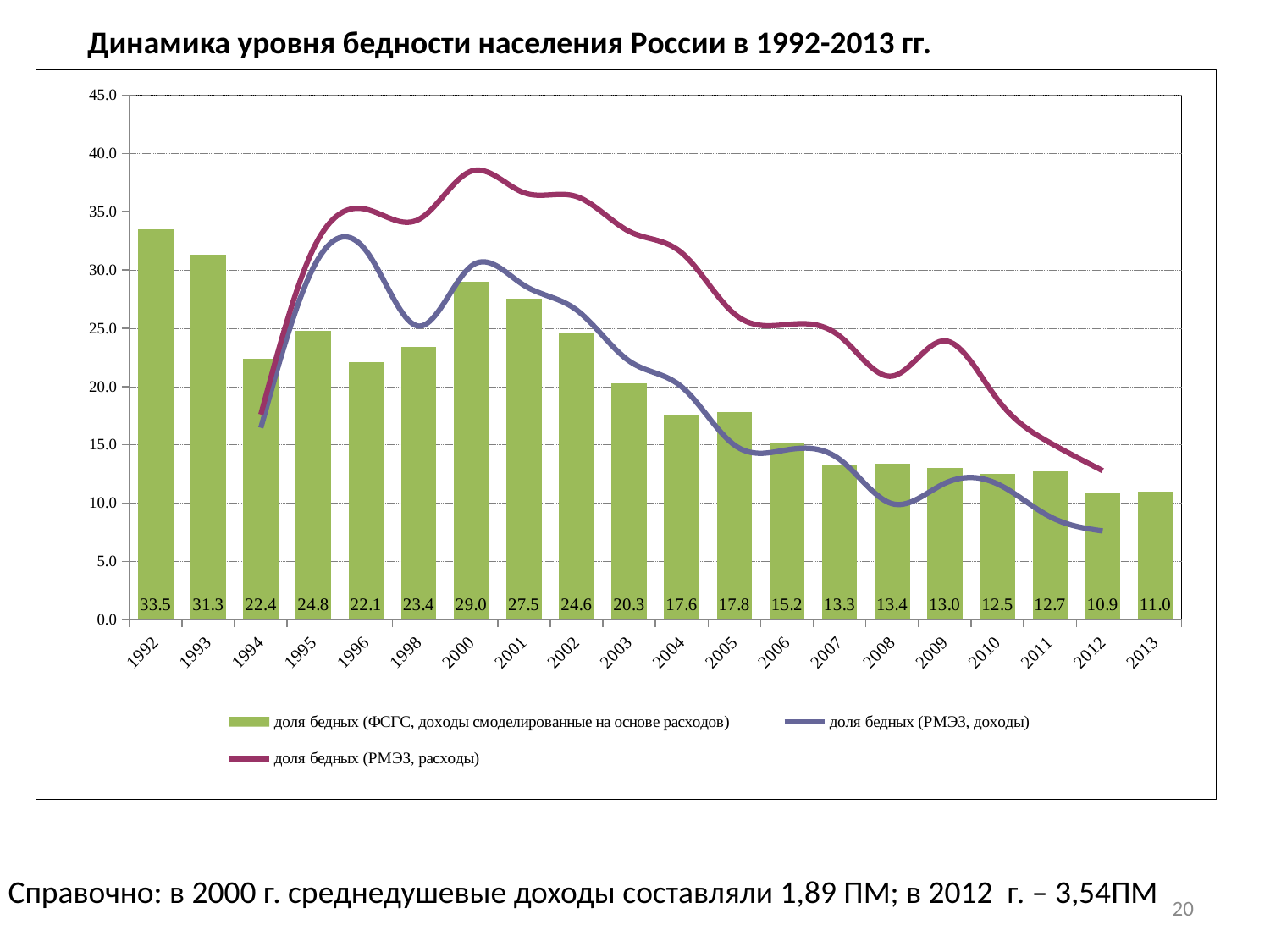
What is the difference between the bar values for 1992 and 2013? 22.5 Which year has the lowest bar value? 2012 Is the value of the 'доля бедных (РМЭЗ, расходы)' line for 2000 greater or less than 35.0? greater Which year has the highest bar value? 1992 Is the value of the 'доля бедных (РМЭЗ, доходы)' line for 2012 greater or less than 10.0? less Which bar is larger, 2000 or 2001? 2000 Do the bar values generally rise or fall from 2000 to 2013? fall How many years are shown on the x axis? 20 What is the value of the bar for 2000? 29.0 What is the value of the bar for 1992? 33.5 What is the value of the bar for 2013? 11.0 How many series does the legend list? 3